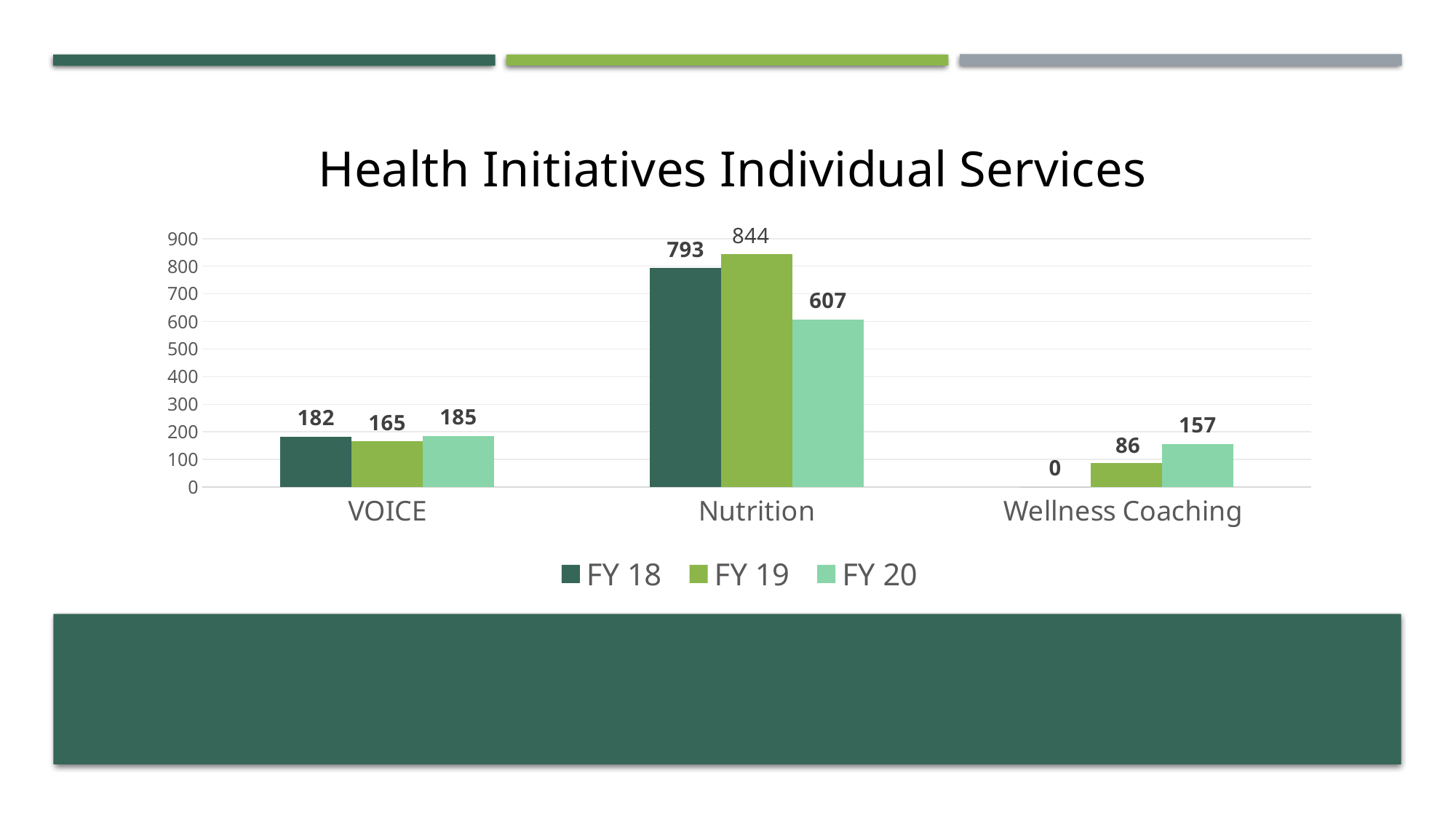
Is the FY 18 value for Nutrition greater or less than 700? greater What is the FY 18 value for VOICE? 182 Which category has the highest FY 20 value? Nutrition What kind of chart is shown on the slide? bar chart Which category has the lowest FY 18 value? Wellness Coaching What is the difference between the FY 19 and FY 20 values for Nutrition? 237 How many series does the legend list? 3 Which is larger for VOICE, the FY 18 value or the FY 19 value? FY 18 What is the title of the chart? Health Initiatives Individual Services How many categories are shown on the x axis? 3 What is the FY 19 value for Nutrition? 844 What is the FY 20 value for Wellness Coaching? 157